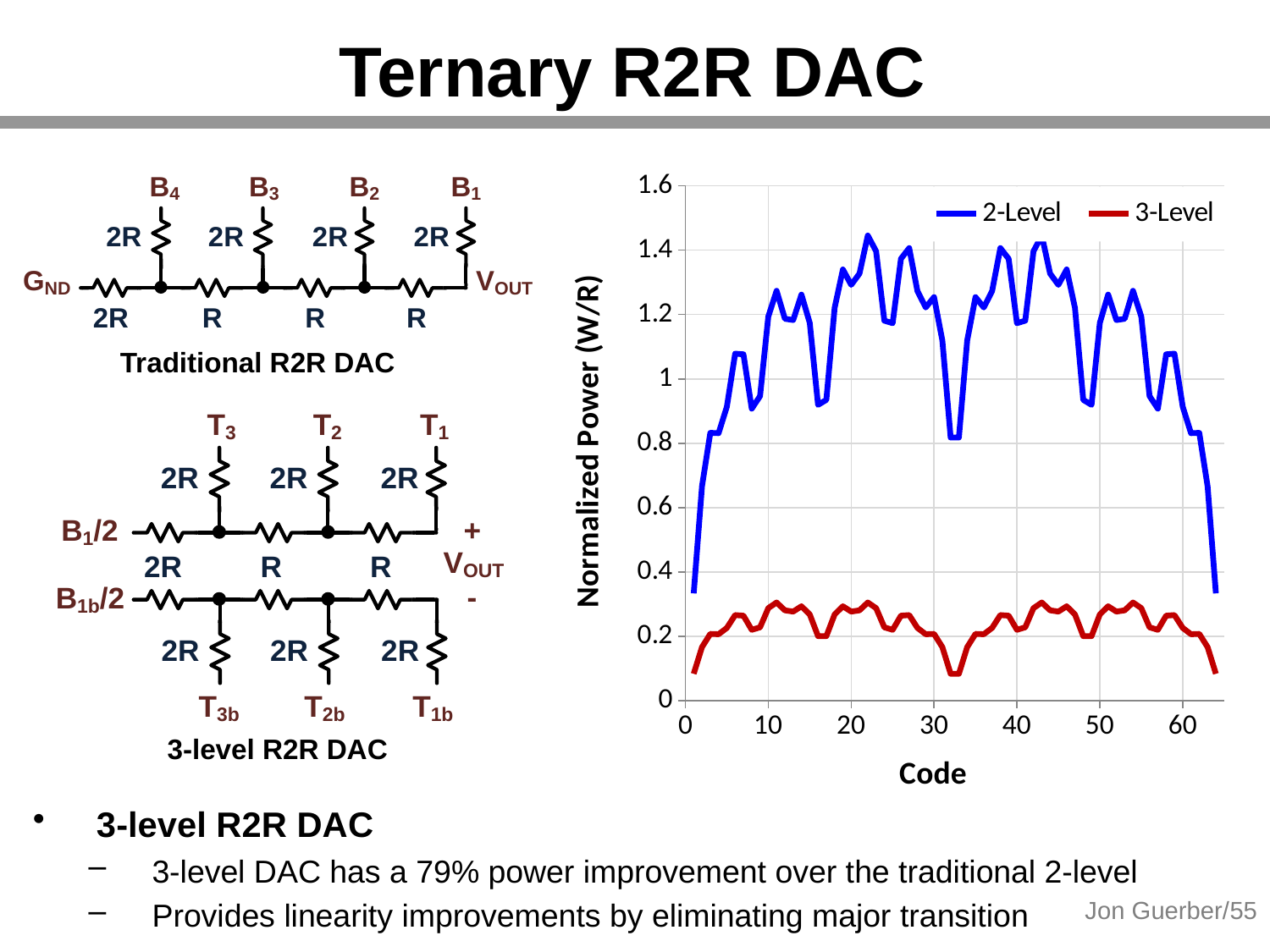
What is the label of the chart's vertical axis? Normalized Power (W/R) Is the value of the 3-Level series at code 32 greater or less than 0.2? less At code 20, which series has the larger value, 2-Level or 3-Level? 2-Level How many series does the chart's legend list? 2 Is the value of the 2-Level series at code 32 greater or less than 1? less What are the two series named in the chart's legend? 2-Level and 3-Level Which series has the higher normalized power across the codes, 2-Level or 3-Level? 2-Level Is the highest value of the 3-Level series greater or less than 0.4? less Does the 2-Level series rise or fall between code 0 and code 10? rise Does the 2-Level series rise or fall between code 60 and the end of the x axis? fall What kind of chart is shown on the slide? line chart